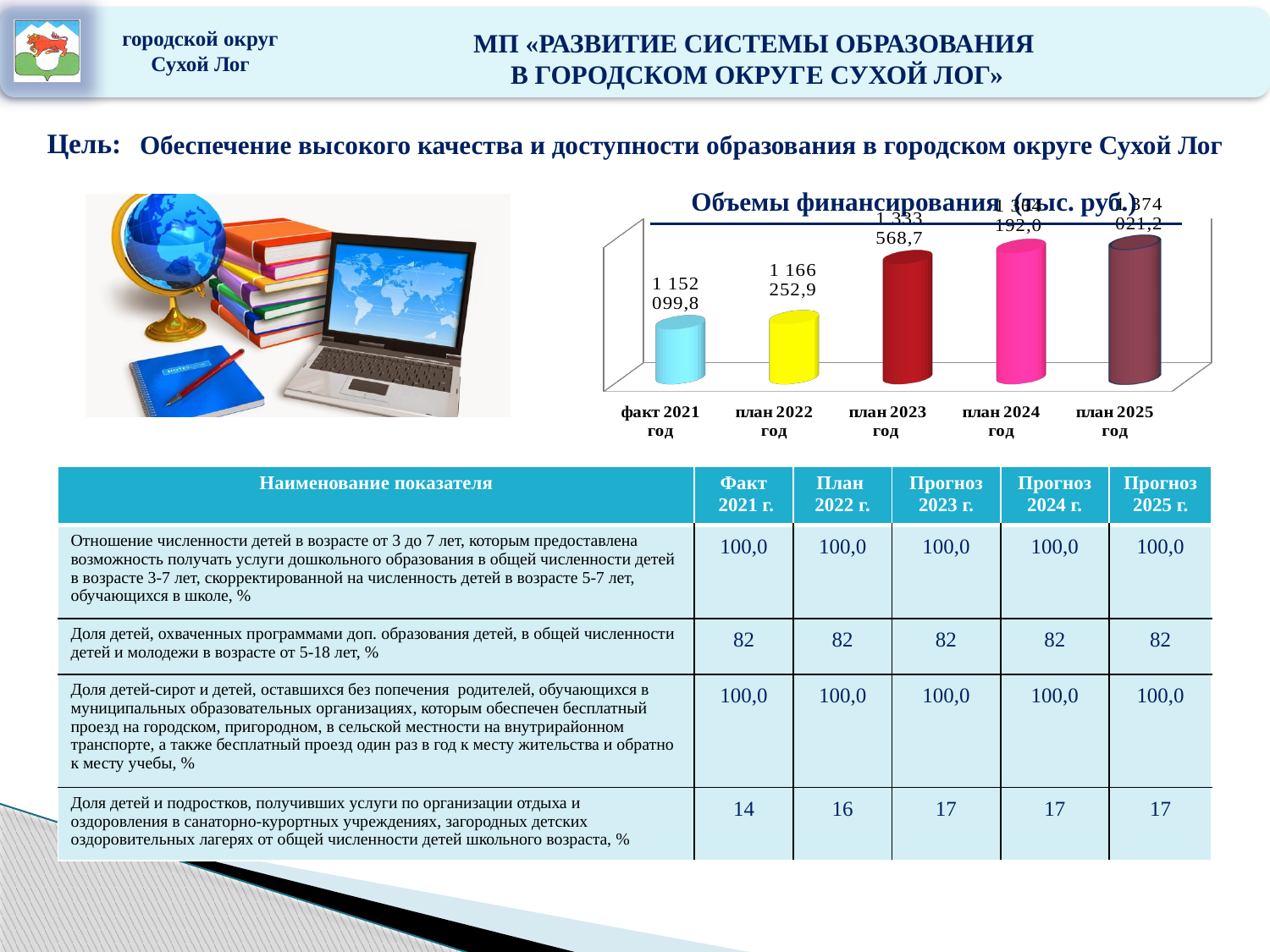
Which is larger, the financing value for план 2023 год or план 2022 год? план 2023 год What kind of chart is used to show the financing volumes? bar chart What is the difference between the financing values for план 2022 год and факт 2021 год? 14 153,1 What is the financing value for план 2023 год? 1 333 568,7 What is the financing value for план 2022 год? 1 166 252,9 Which category has the lowest financing value in the chart? факт 2021 год What is the difference between the financing values for план 2023 год and план 2022 год? 167 315,8 How many categories (years) are shown in the financing chart? 5 Which category has the highest financing value in the chart? план 2025 год Do the financing values rise or fall from факт 2021 год to план 2025 год? rise What is the title of the chart on the slide? Объемы финансирования (тыс. руб.) What is the financing value for факт 2021 год? 1 152 099,8